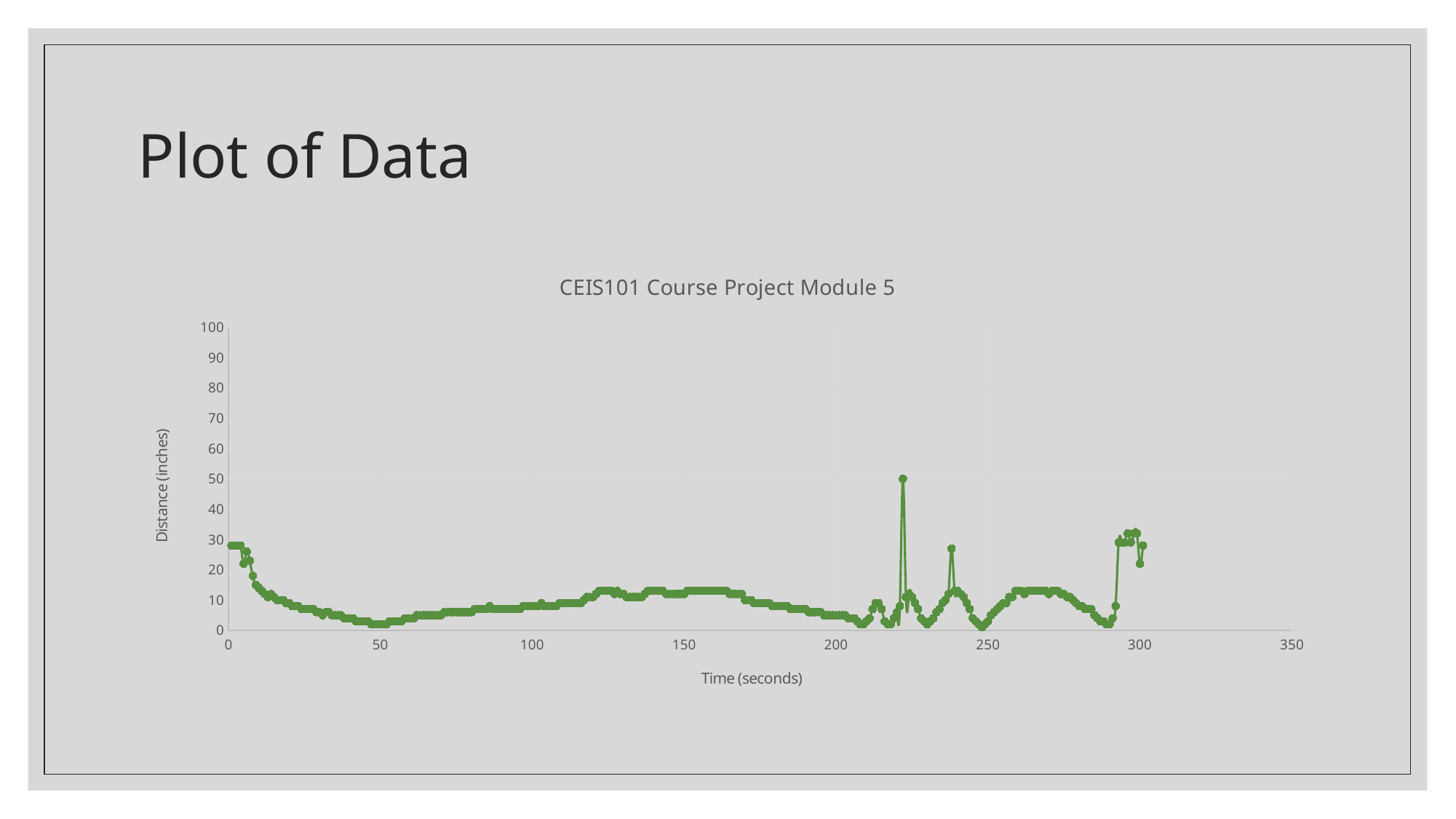
What kind of chart is shown on the slide? line chart What is the label of the vertical axis of the chart? Distance (inches) Is the distance value at time 0 seconds greater or less than 20? greater Do the distance values rise or fall between 50 and 125 seconds? rise Do the distance values rise or fall between 0 and 50 seconds? fall Is the distance value at around 50 seconds greater or less than 10? less Is the highest spike in distance, near 220 seconds, greater or less than 40? greater What is the title of the chart? CEIS101 Course Project Module 5